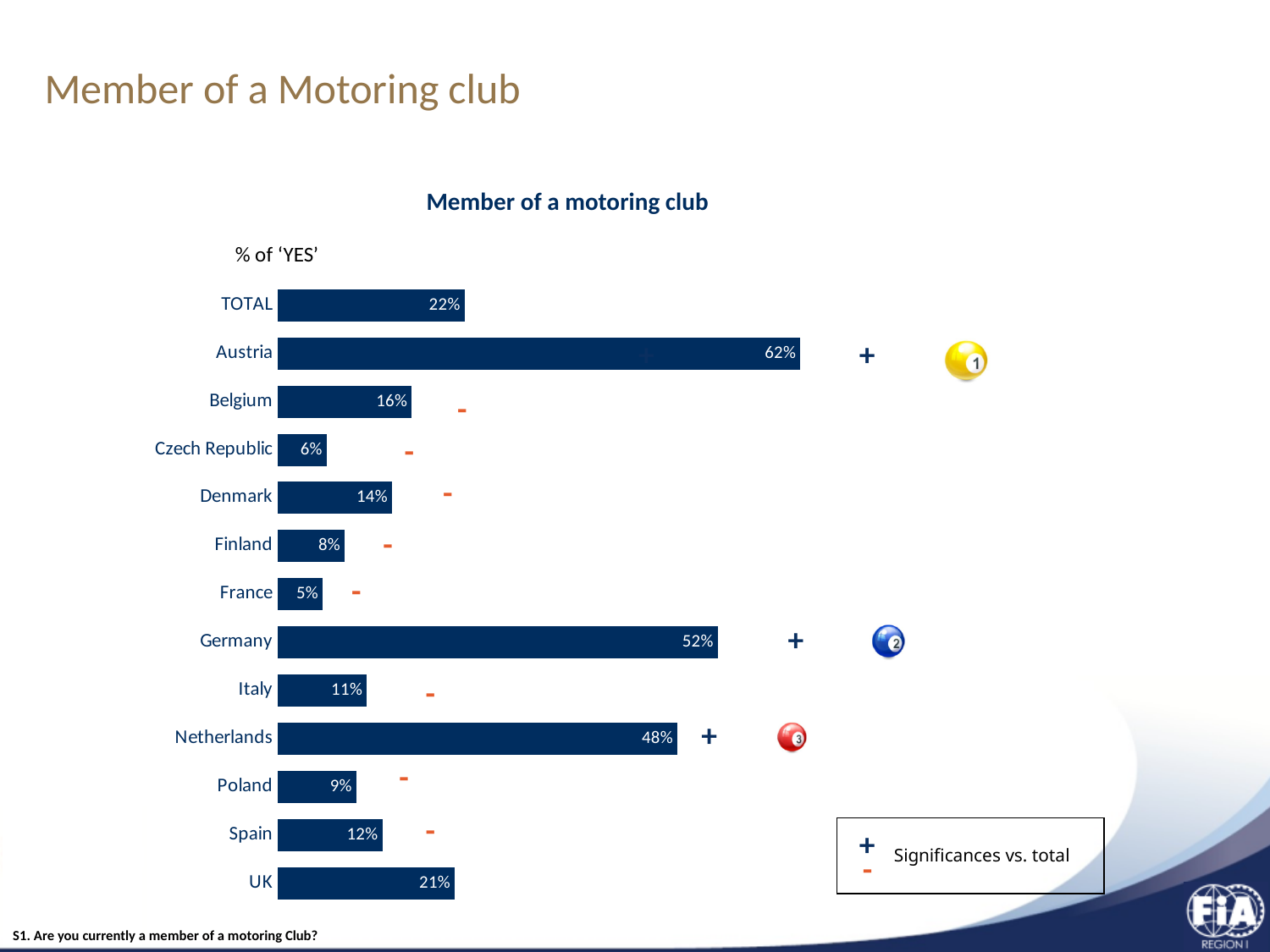
What is the title of the chart? Member of a motoring club What is the value for TOTAL? 22% What is the difference between the values for the UK and the TOTAL? 1% Which country has the lowest percentage of 'YES'? France Which country has the highest percentage of 'YES'? Austria What is the difference between the values for Austria and Germany? 10% Which is larger, the value for Belgium or the value for Denmark? Belgium What kind of chart is shown on the slide? Bar chart What is the value for Austria? 62% How many bars are shown in the chart, including TOTAL? 13 What is the value for the Netherlands? 48% Which is larger, the value for Germany or the value for the Netherlands? Germany